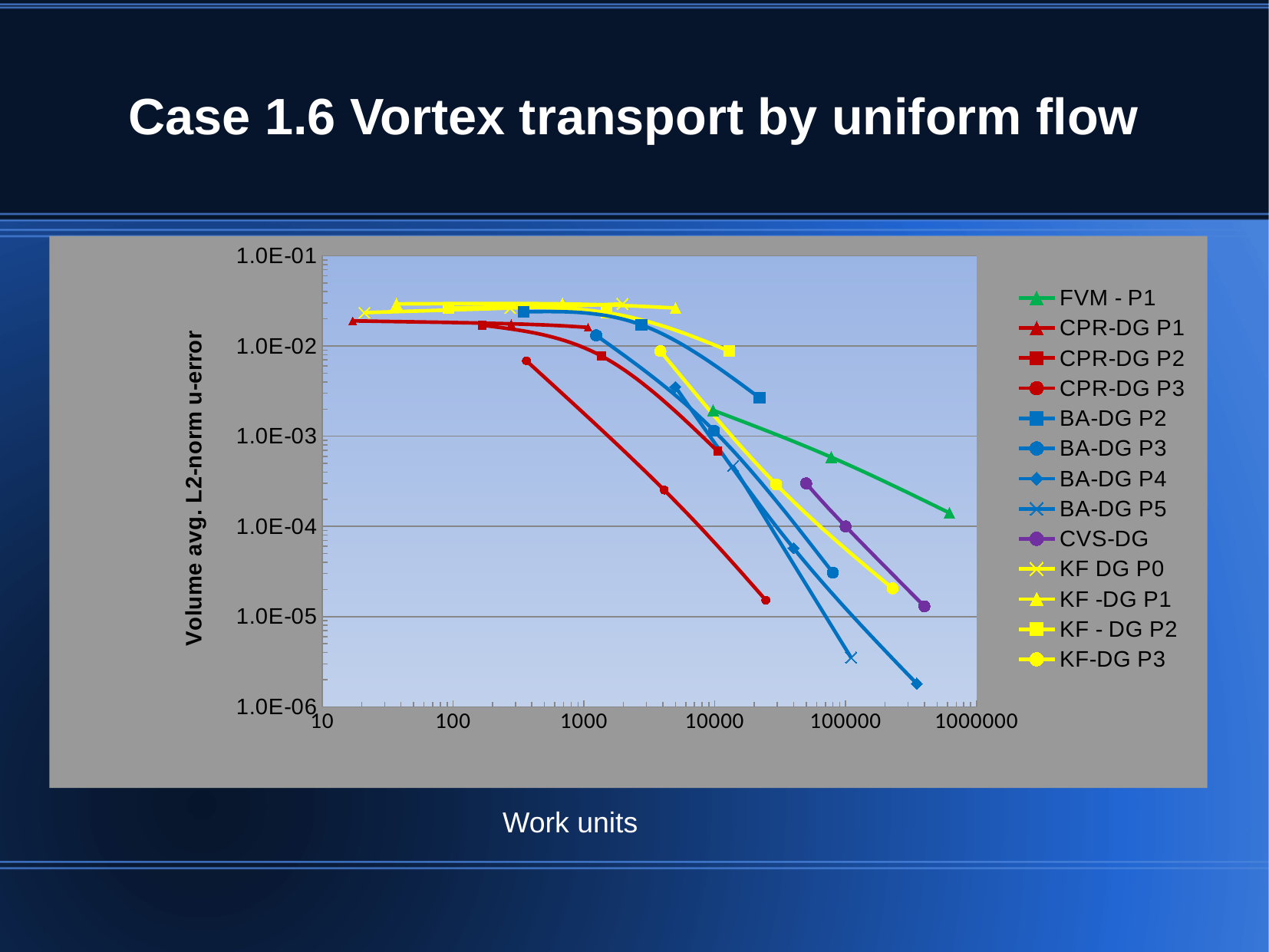
How many series does the legend list? 13 Is the lowest error value reached by FVM - P1 greater or less than 1.0E-03? less Is the lowest error value reached by BA-DG P5 greater or less than 1.0E-05? less Is the lowest error value reached by CPR-DG P3 greater or less than 1.0E-04? less What kind of chart is shown on the slide? Line chart What is the label of the x axis? Work units What is the label of the y axis? Volume avg. L2-norm u-error Which series reaches the lowest error value on the chart? BA-DG P4 At its lowest point, which series has the larger error: FVM - P1 or CPR-DG P3? FVM - P1 As work units increase, do the error values for CPR-DG P3 rise or fall? Fall